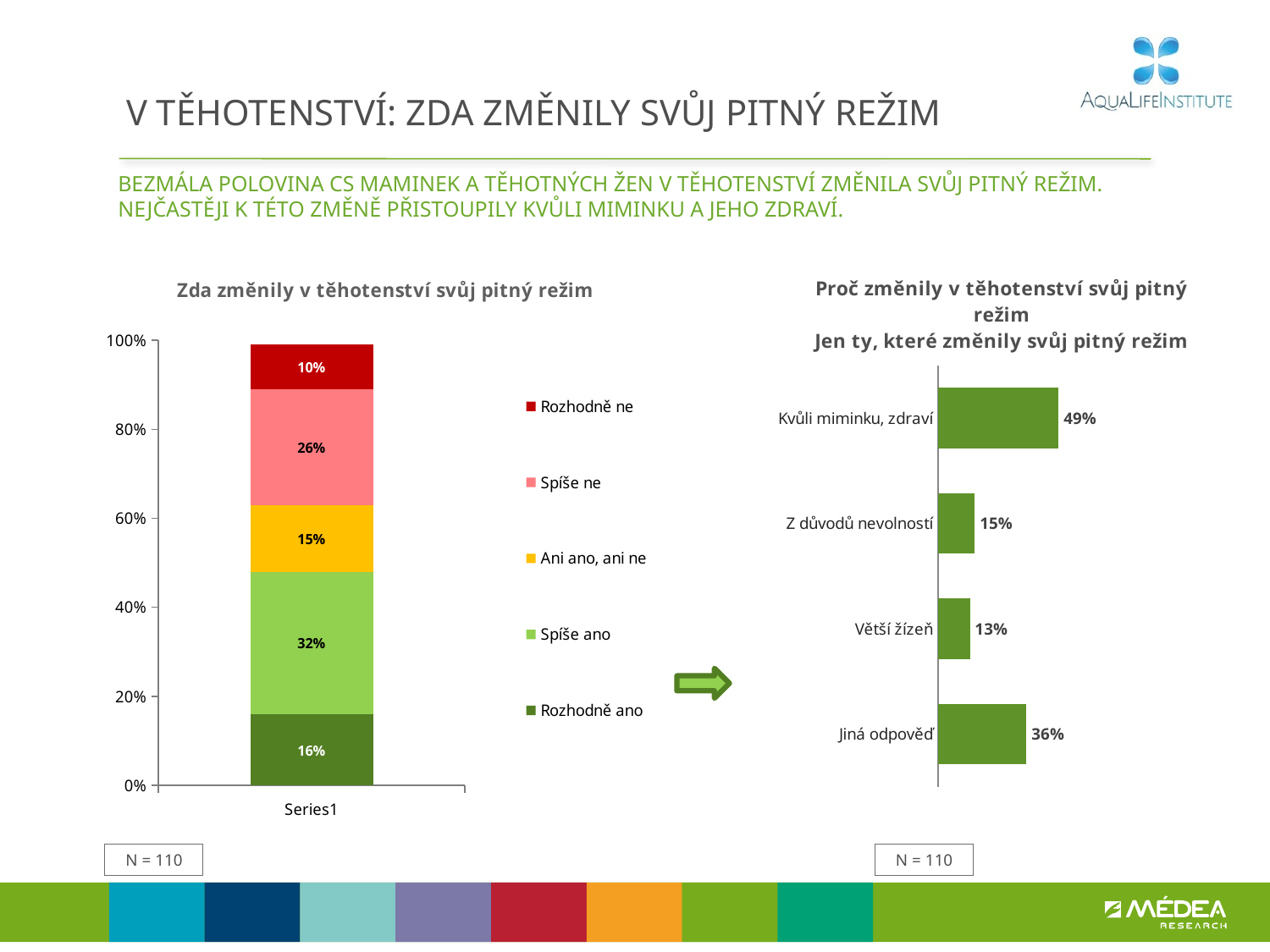
In the right chart 'Proč změnily v těhotenství svůj pitný režim', what is the difference between 'Kvůli miminku, zdraví' and 'Jiná odpověď'? 13% In the left chart 'Zda změnily v těhotenství svůj pitný režim', which response has the largest share? Spíše ano In the left chart 'Zda změnily v těhotenství svůj pitný režim', how many series does the legend list? 5 In the right chart 'Proč změnily v těhotenství svůj pitný režim', which reason has the lowest value? Větší žízeň What type of chart is the right chart 'Proč změnily v těhotenství svůj pitný režim'? Bar chart In the right chart 'Proč změnily v těhotenství svůj pitný režim', which is larger: 'Z důvodů nevolností' or 'Jiná odpověď'? Jiná odpověď In the left chart 'Zda změnily v těhotenství svůj pitný režim', what is the difference between 'Spíše ano' and 'Ani ano, ani ne'? 17% In the left chart 'Zda změnily v těhotenství svůj pitný režim', which response has the smallest share? Rozhodně ne In the left chart 'Zda změnily v těhotenství svůj pitný režim', what percentage is shown for 'Rozhodně ano'? 16% In the right chart 'Proč změnily v těhotenství svůj pitný režim', what is the value for 'Kvůli miminku, zdraví'? 49% In the right chart 'Proč změnily v těhotenství svůj pitný režim', how many categories are shown? 4 In the left chart 'Zda změnily v těhotenství svůj pitný režim', what percentage is shown for 'Spíše ne'? 26%